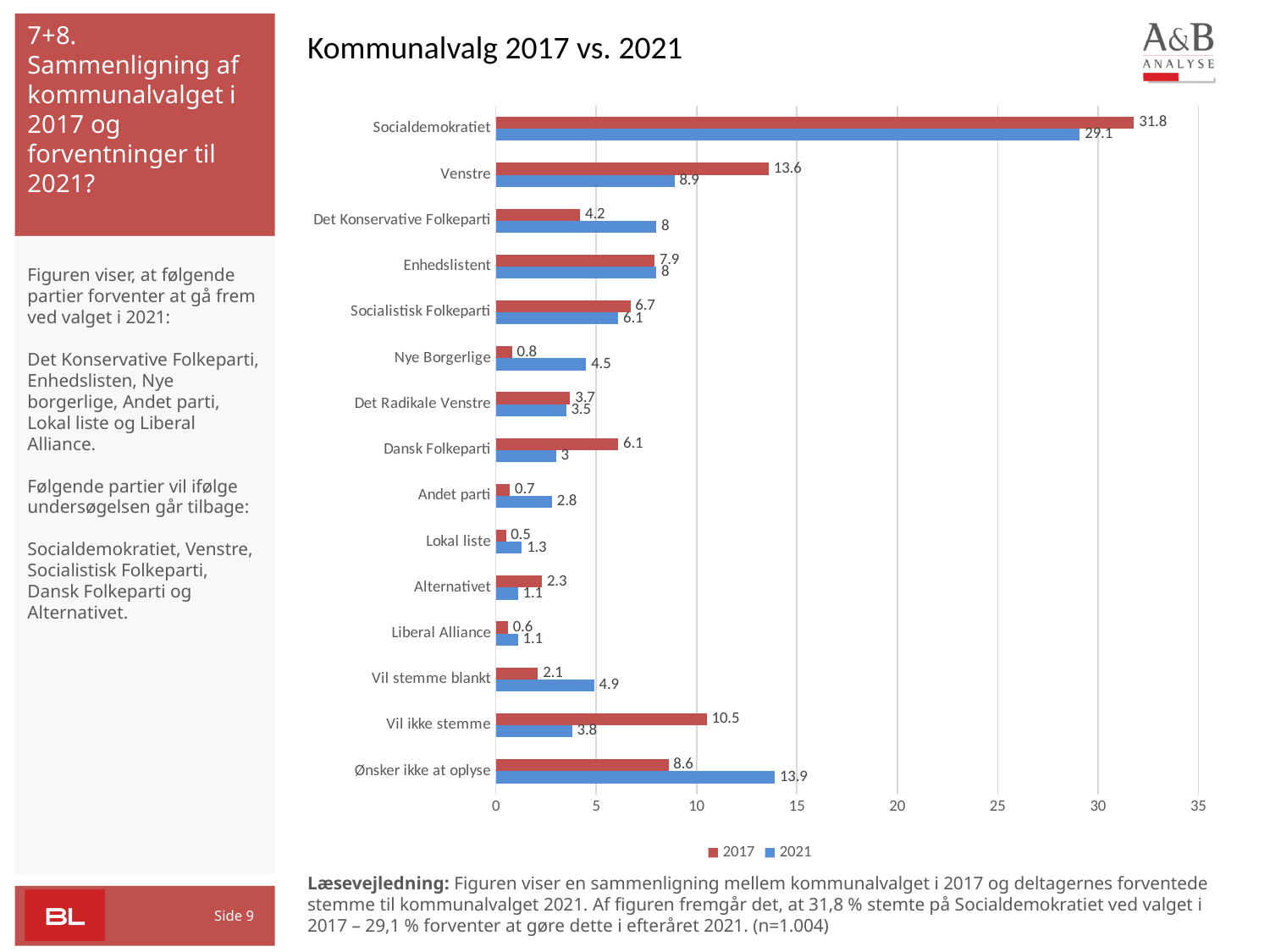
What type of chart is shown on the slide? Bar chart What is the 2021 value for Ønsker ikke at oplyse? 13.9 What is the difference between the 2017 and 2021 values for Socialdemokratiet? 2.7 How many categories are shown on the y axis of the chart? 15 Which category has the highest 2017 value? Socialdemokratiet Is the 2017 value for Socialdemokratiet greater or less than 30? greater What is the 2017 value for Venstre? 13.6 Which category has the lowest 2017 value? Lokal liste What is the difference between the 2017 and 2021 values for Vil ikke stemme? 6.7 What is the 2021 value for Nye Borgerlige? 4.5 For Det Konservative Folkeparti, which is larger: the 2017 value or the 2021 value? 2021 How many series does the legend list? 2